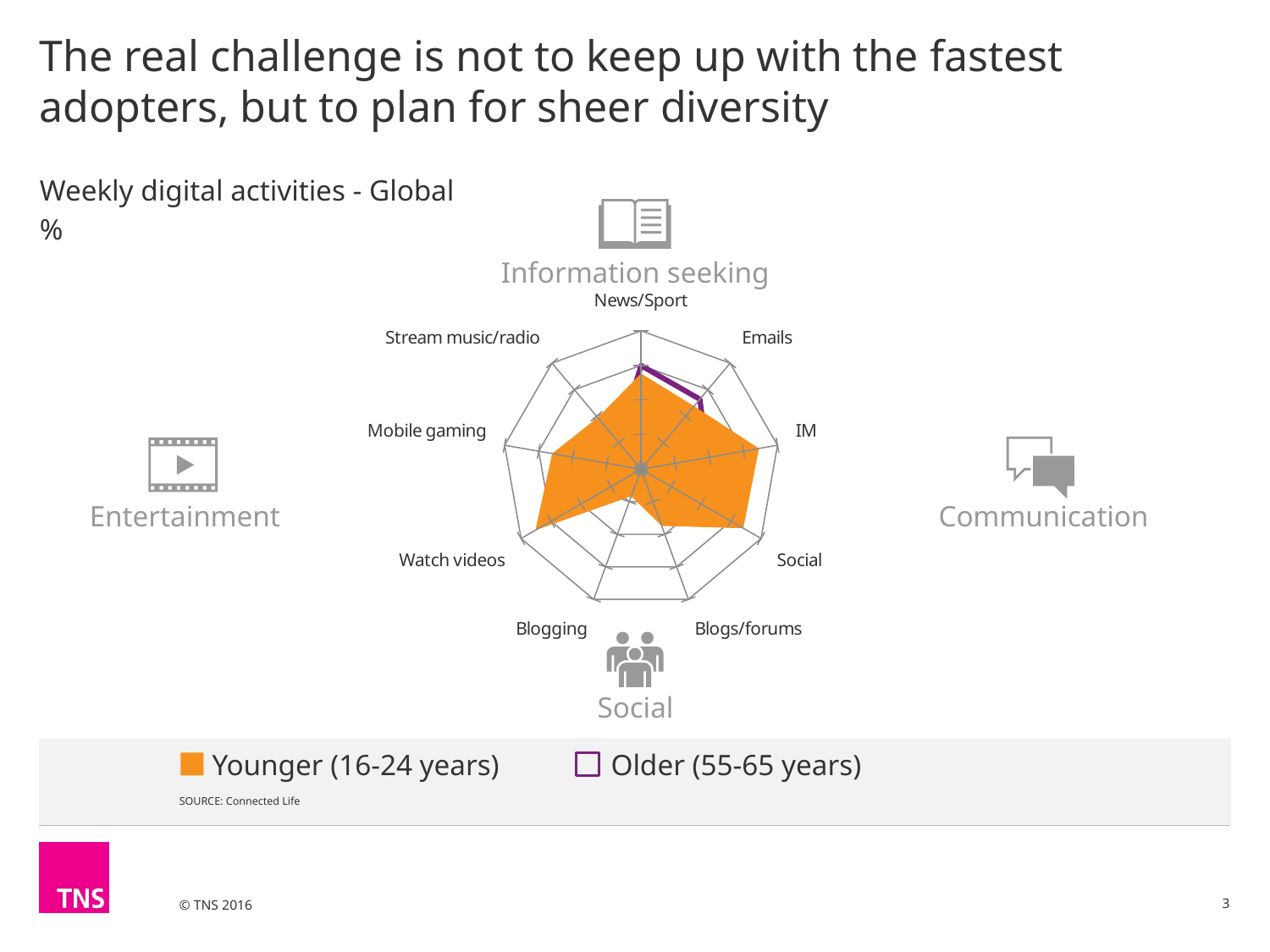
For the Younger (16-24 years) series, which is larger: Watch videos or Blogging? Watch videos For the Social activity, which series has the larger value: Younger (16-24 years) or Older (55-65 years)? Younger (16-24 years) What is the title of the chart? Weekly digital activities - Global % What colour represents the Younger (16-24 years) series? Orange What kind of chart is shown on the slide? Radar chart Which activity has the lowest value for the Younger (16-24 years) series? Blogging For the Younger (16-24 years) series, which is larger: Social or News/Sport? Social How many activity categories are plotted on the radar chart? 9 How many series does the legend list? 2